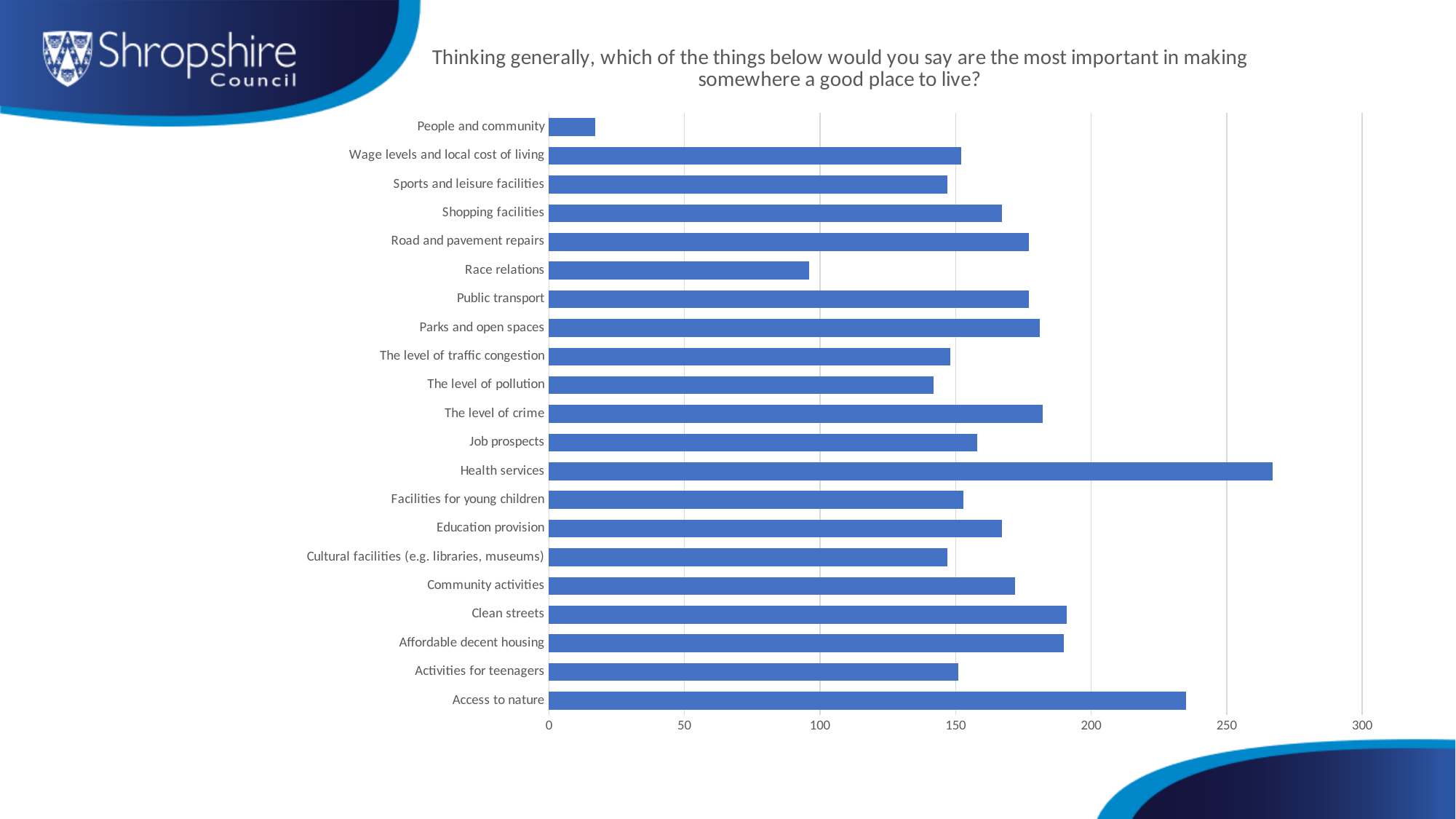
Which category has the lowest value? People and community Is the value for Race relations greater or less than 100? less Is the value for The level of pollution greater or less than 150? less Which is larger, the value for Access to nature or the value for Clean streets? Access to nature Is the value for Access to nature greater or less than 200? greater How many categories are plotted on the chart? 21 Which category has the highest value? Health services What is the title of the chart? Thinking generally, which of the things below would you say are the most important in making somewhere a good place to live? Which is larger, the value for Race relations or the value for Public transport? Public transport What kind of chart is shown on the slide? Bar chart